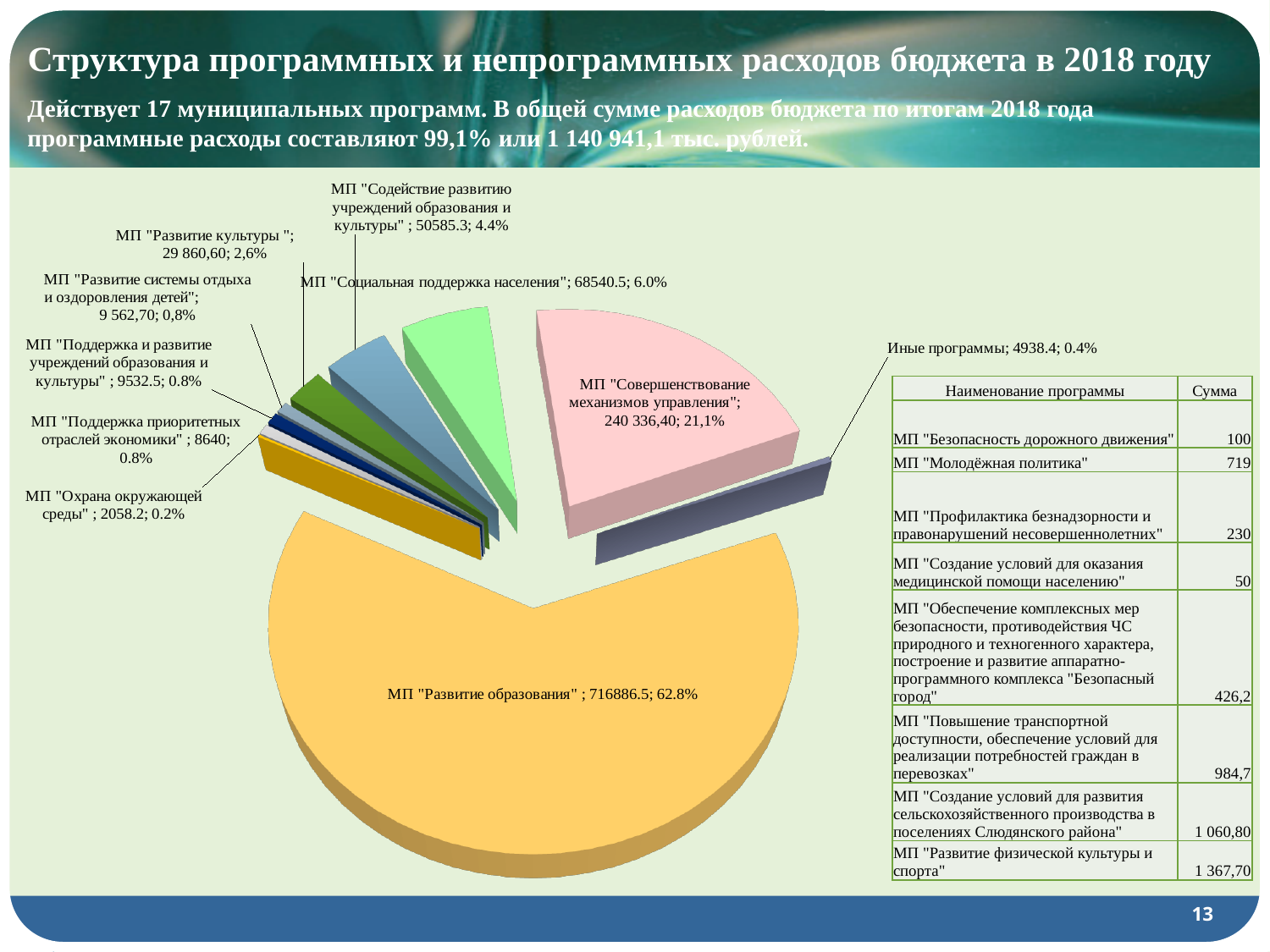
Which is larger: the slice for МП "Социальная поддержка населения" or the slice for МП "Содействие развитию учреждений образования и культуры"? МП "Социальная поддержка населения" What share of the pie does МП "Развитие образования" account for? 62.8% Which program has the smallest slice in the pie chart? МП "Охрана окружающей среды" What share of the pie does МП "Содействие развитию учреждений образования и культуры" account for? 4.4% What is the value shown for МП "Социальная поддержка населения"? 68540.5 Which program has the largest slice in the pie chart? МП "Развитие образования" What share of the pie does "Иные программы" account for? 0.4% What is the value shown for МП "Развитие образования"? 716886.5 What is the value shown for МП "Совершенствование механизмов управления"? 240 336,40 What is the difference in percentage share between МП "Развитие образования" (62.8%) and МП "Совершенствование механизмов управления" (21,1%)? 41.7% What kind of chart is shown on the slide? Pie chart How many slices (categories) are labelled in the pie chart? 10